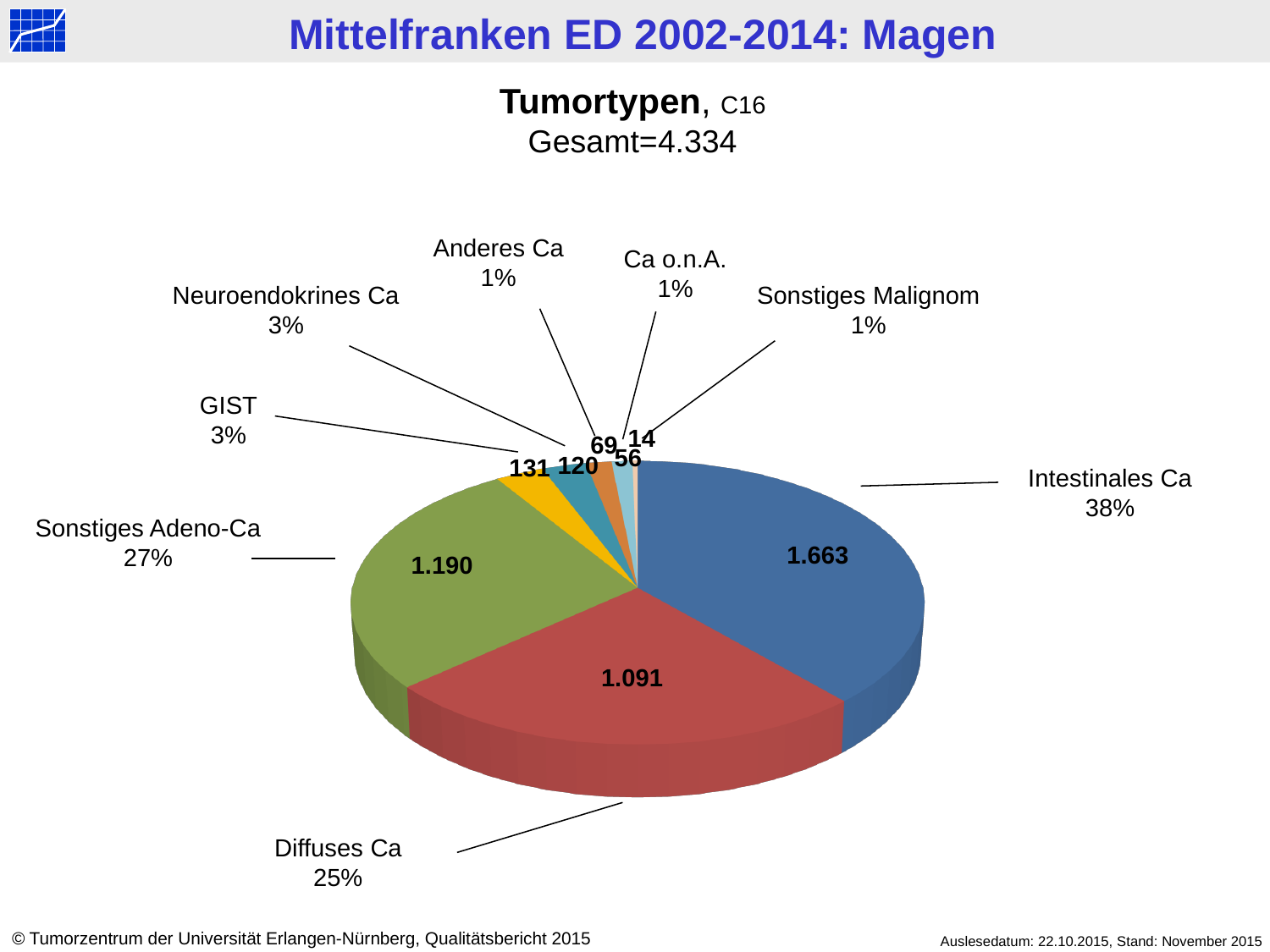
What kind of chart is shown on the slide? pie chart Which category has the largest share of the pie? Intestinales Ca What share of the pie does Sonstiges Adeno-Ca represent? 27% What is the value shown for GIST? 131 What is the value shown for Diffuses Ca? 1.091 What is the difference between the values for Intestinales Ca and Diffuses Ca? 572 What total (Gesamt) is stated for the chart? 4.334 How many categories (tumour types) does the pie chart show? 8 What is the value shown for Sonstiges Adeno-Ca? 1.190 What is the value shown for Intestinales Ca? 1.663 What is the value shown for Neuroendokrines Ca? 120 Which is larger, the value for Sonstiges Adeno-Ca or the value for Diffuses Ca? Sonstiges Adeno-Ca